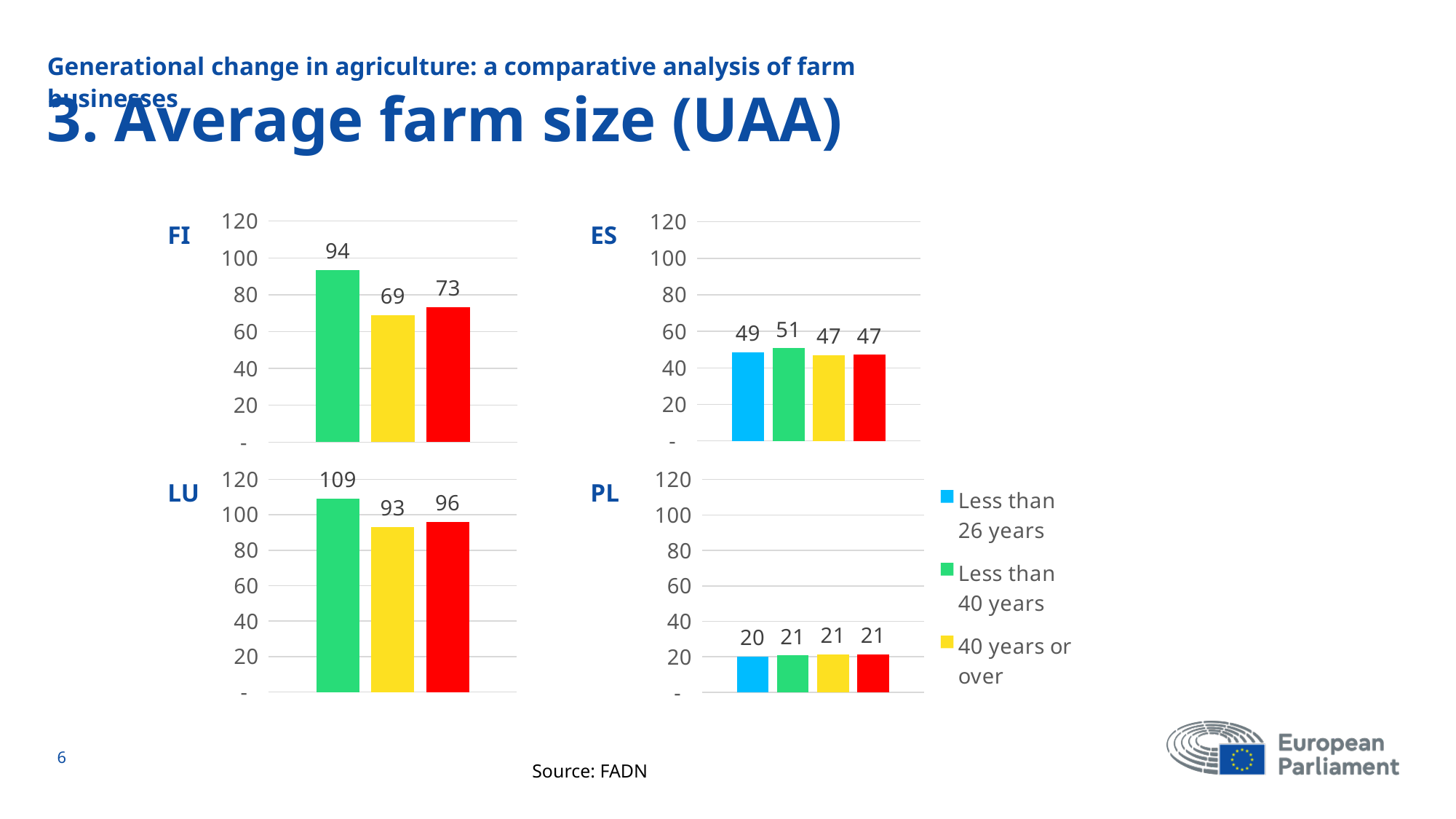
In the FI chart, what is the value for Less than 40 years? 94 How many series does the legend list? 3 In the PL chart, what is the value for Less than 26 years? 20 Across the four charts, which country has the highest value for Less than 40 years? LU In the LU chart, is the value for Less than 40 years greater or less than 100? greater In the FI chart, what is the difference between the values for Less than 40 years and 40 years or over? 25 What kind of chart is the FI chart? bar chart In the ES chart, what is the difference between the values for Less than 40 years and 40 years or over? 4 In the LU chart, which legend series has the highest value? Less than 40 years In the LU chart, what is the value for 40 years or over? 93 In the ES chart, what is the value for Less than 26 years? 49 In the ES chart, which is larger: the value for Less than 26 years or the value for Less than 40 years? Less than 40 years